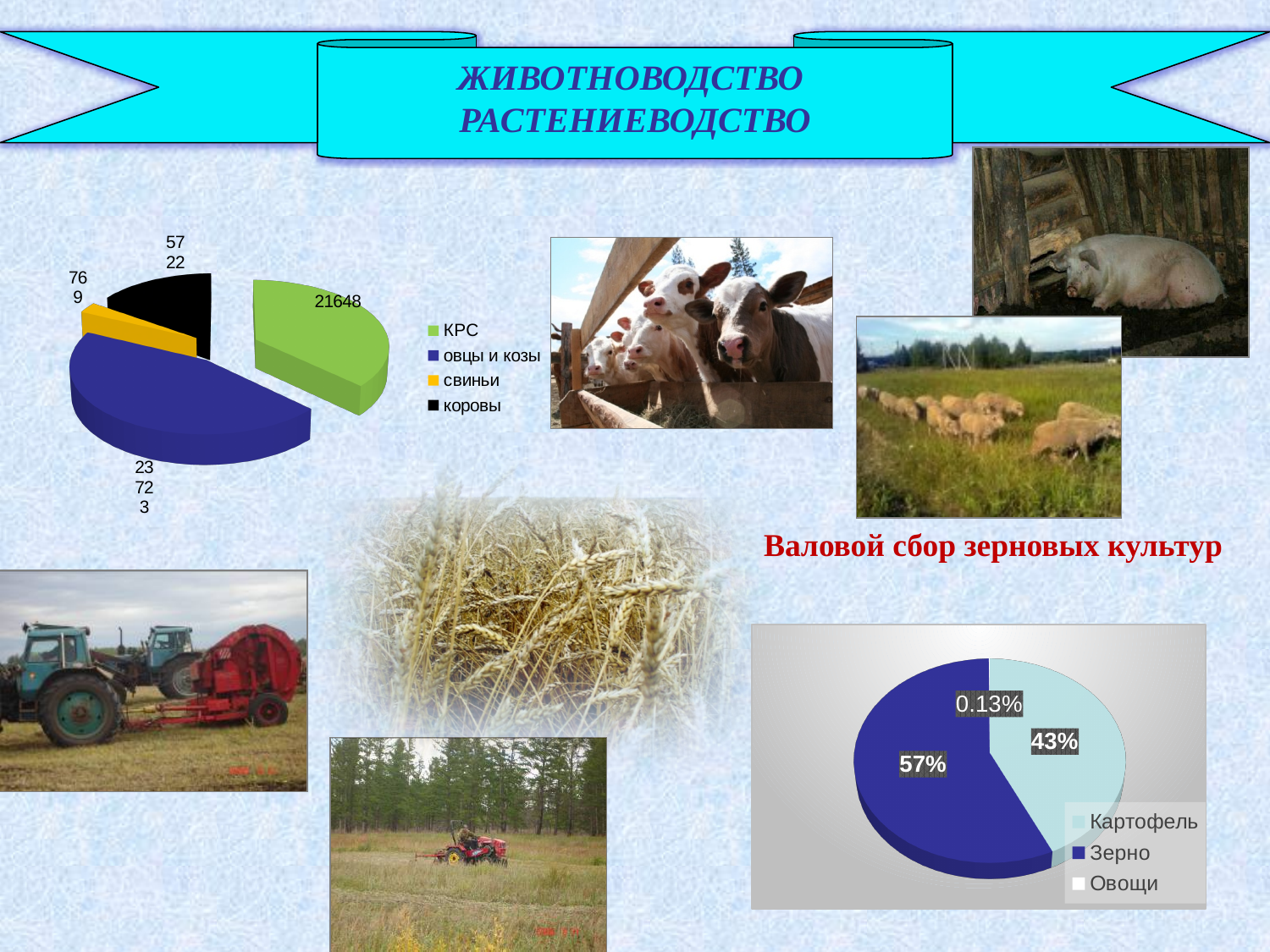
On the chart titled 'Валовой сбор зерновых культур', which category has the largest share? Зерно On the chart titled 'Валовой сбор зерновых культур', what is the share for Картофель? 43% On the chart titled 'Валовой сбор зерновых культур', what is the share for Зерно? 57% On the left pie chart, what is the value for КРС? 21648 On the chart titled 'Валовой сбор зерновых культур', what is the share for Овощи? 0.13% On the left pie chart, which colour represents КРС in the legend? green On the chart titled 'Валовой сбор зерновых культур', what is the difference between the shares of Зерно and Картофель? 14% How many categories does the chart titled 'Валовой сбор зерновых культур' list in its legend? 3 On the left pie chart, which category has the largest slice? овцы и козы What kind of chart is the chart on the left of the slide? pie chart On the left pie chart, which category has the smallest slice? свиньи How many categories does the left pie chart show? 4